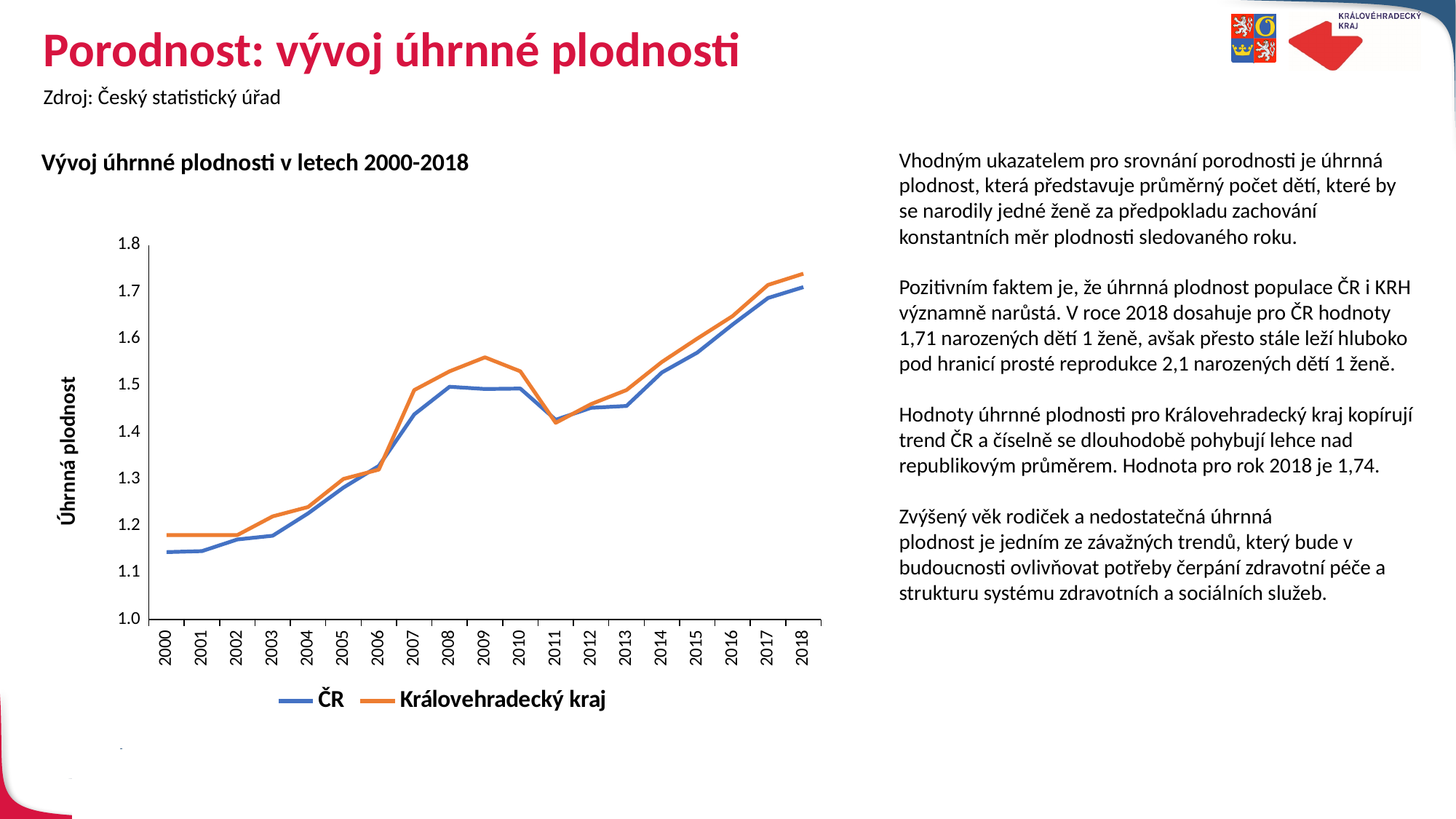
Which year has the highest value for the Královehradecký kraj series? 2018 How many years are plotted on the x axis of the chart? 19 Is the value for ČR in 2000 greater or less than 1.2? less In 2009, which series has the larger value, ČR or Královehradecký kraj? Královehradecký kraj Do the values for ČR generally rise or fall from 2000 to 2018? rise Is the value for Královehradecký kraj in 2004 greater or less than 1.2? greater Which year has the highest value for the ČR series? 2018 What kind of chart is shown on the slide? line chart Is the value for Královehradecký kraj in 2009 greater or less than 1.5? greater What is the title of the chart's vertical axis? Úhrnná plodnost How many series does the chart legend list? 2